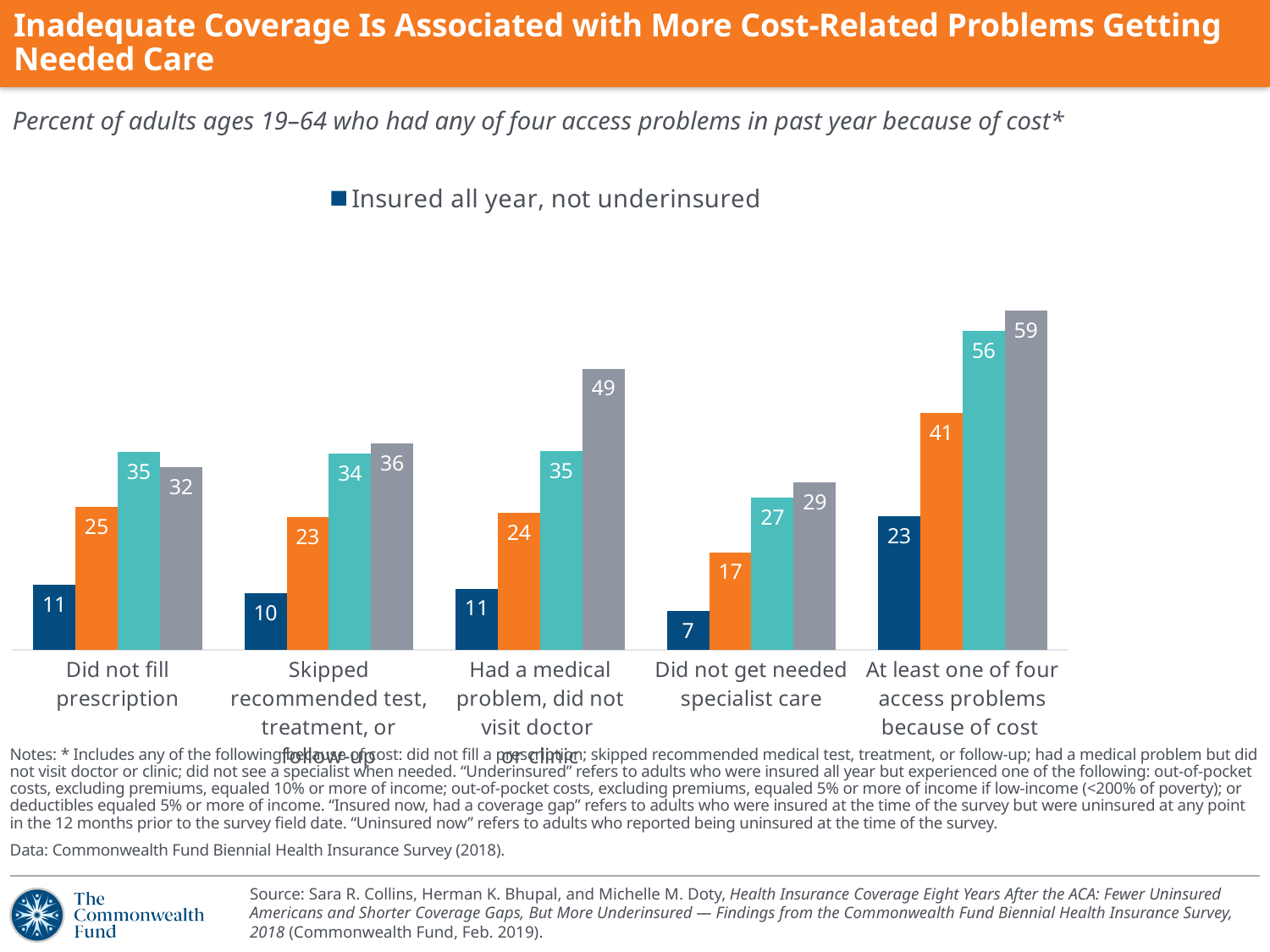
What is the value for "Insured all year, not underinsured" in the "Did not fill prescription" category? 11 How many categories are shown on the x axis of the chart? 5 What is the highest value shown in the "Had a medical problem, did not visit doctor or clinic" category? 49 What kind of chart is shown on the slide? Bar chart For the "Insured all year, not underinsured" series, what is the difference between the value for "At least one of four access problems because of cost" and the value for "Did not get needed specialist care"? 16 What is the highest value labeled anywhere on the chart? 59 What series name is shown in the chart legend? Insured all year, not underinsured For the "Insured all year, not underinsured" series, which category has the lowest value? Did not get needed specialist care What is the value for "Insured all year, not underinsured" in the "Did not get needed specialist care" category? 7 For the "Insured all year, not underinsured" series, which category has the highest value? At least one of four access problems because of cost For the "Insured all year, not underinsured" series, which is larger: the value for "Did not fill prescription" or the value for "Skipped recommended test, treatment, or follow-up"? Did not fill prescription What is the value for "Insured all year, not underinsured" in the "At least one of four access problems because of cost" category? 23